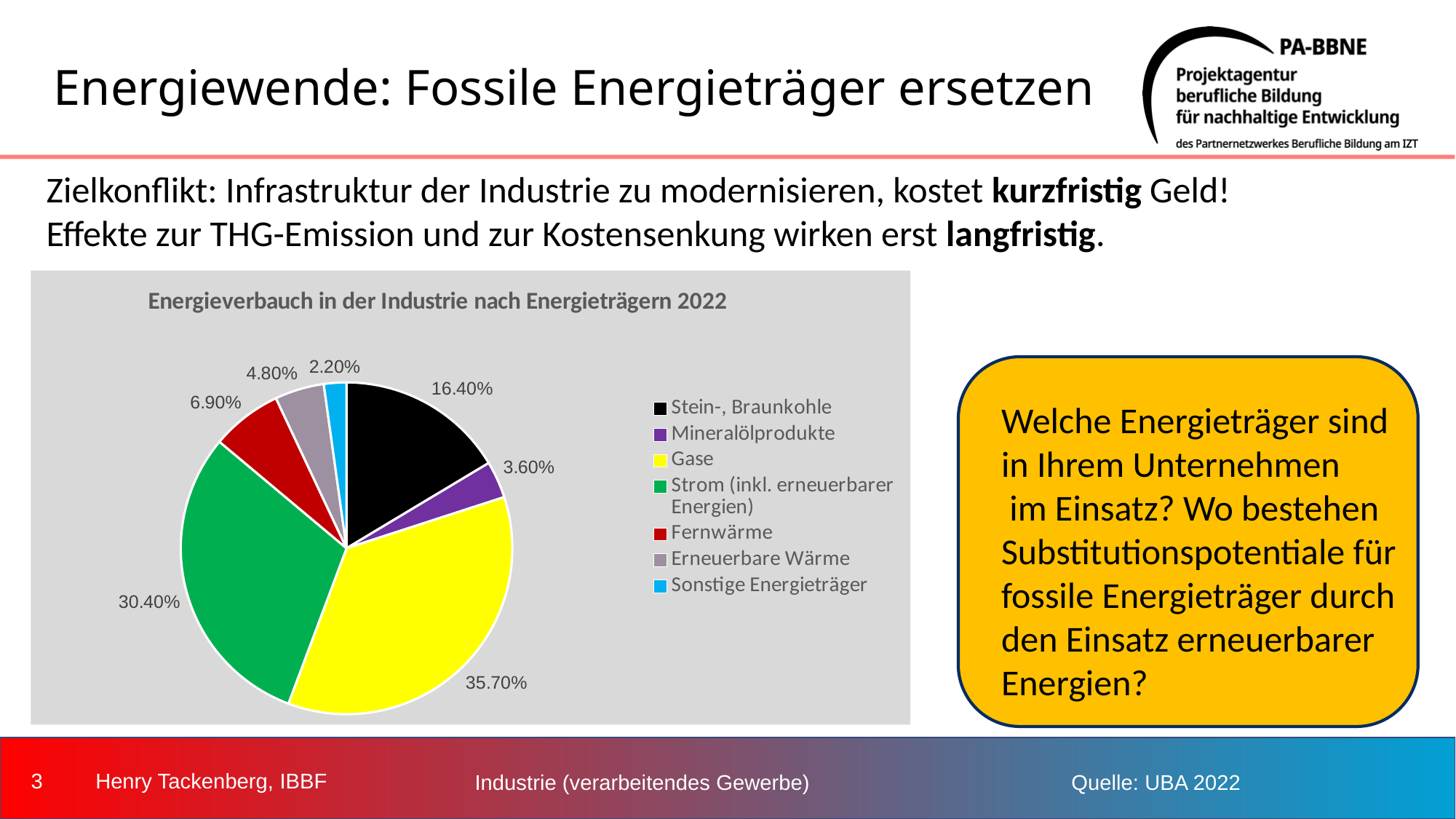
What is the value for Stein-, Braunkohle? 16.40% Which energy source has the largest share of the pie? Gase What is the value for Fernwärme? 6.90% What is the difference between the shares of Gase and Strom (inkl. erneuerbarer Energien)? 5.30% Which energy source has the smallest share of the pie? Sonstige Energieträger How many categories does the legend list? 7 What type of chart is shown on the slide? pie chart Which colour represents Mineralölprodukte in the pie chart? purple Which is larger, the share of Fernwärme or the share of Erneuerbare Wärme? Fernwärme What is the title of the chart? Energieverbauch in der Industrie nach Energieträgern 2022 What is the value for Strom (inkl. erneuerbarer Energien)? 30.40% What share of the pie does Gase have? 35.70%